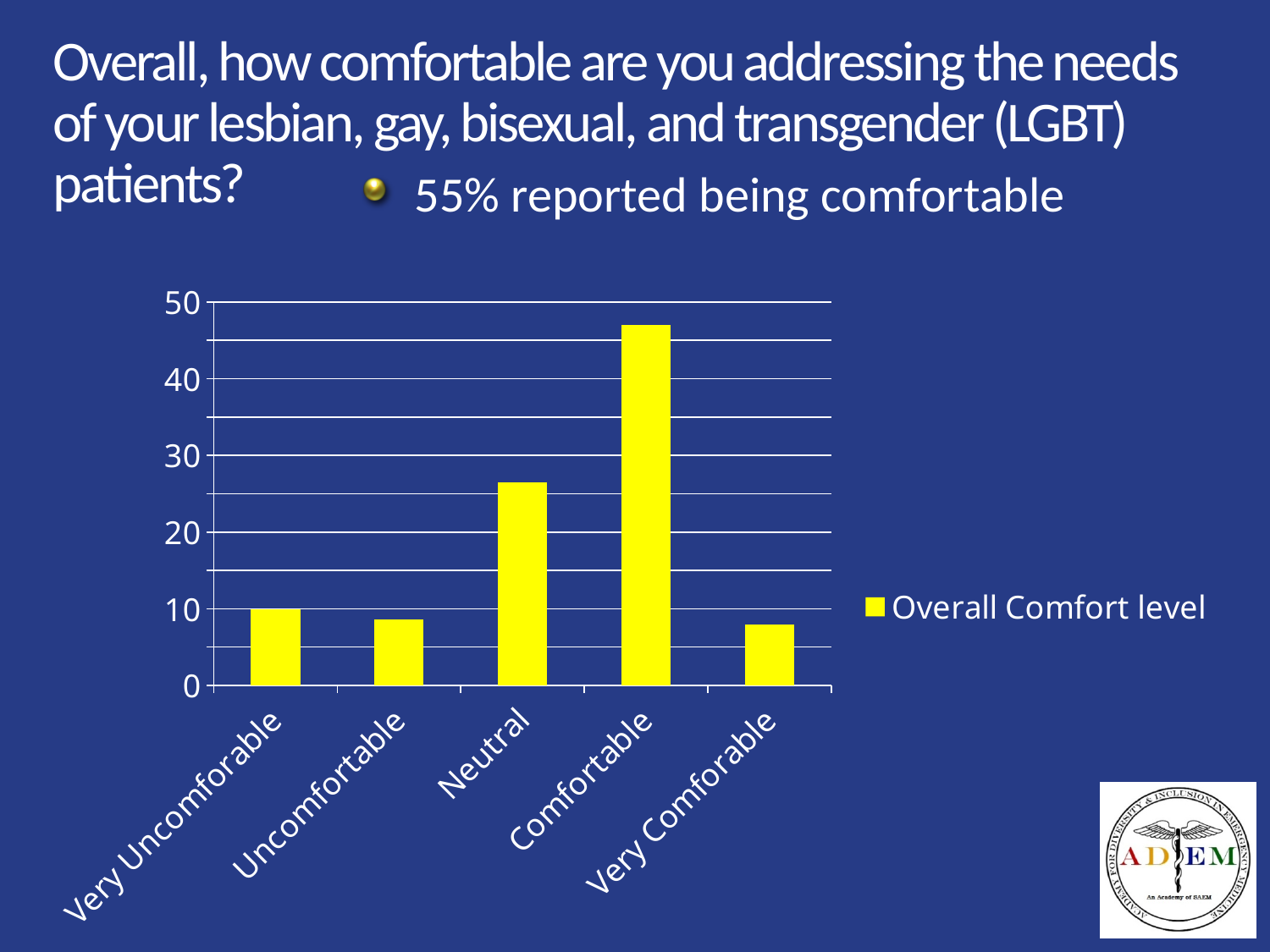
How many series does the chart's legend list? 1 What series name is shown in the chart's legend? Overall Comfort level What colour are the bars in the chart? yellow Is the value for Uncomfortable greater or less than 10? less How many categories are shown on the x axis of the chart? 5 Which category has the highest bar in the chart? Comfortable Is the value for Neutral greater or less than 30? less What kind of chart is shown on the slide? bar chart Which is larger, the value for Neutral or the value for Very Uncomfortable? Neutral Which is larger, the value for Comfortable or the value for Neutral? Comfortable Is the value for Comfortable greater or less than 40? greater